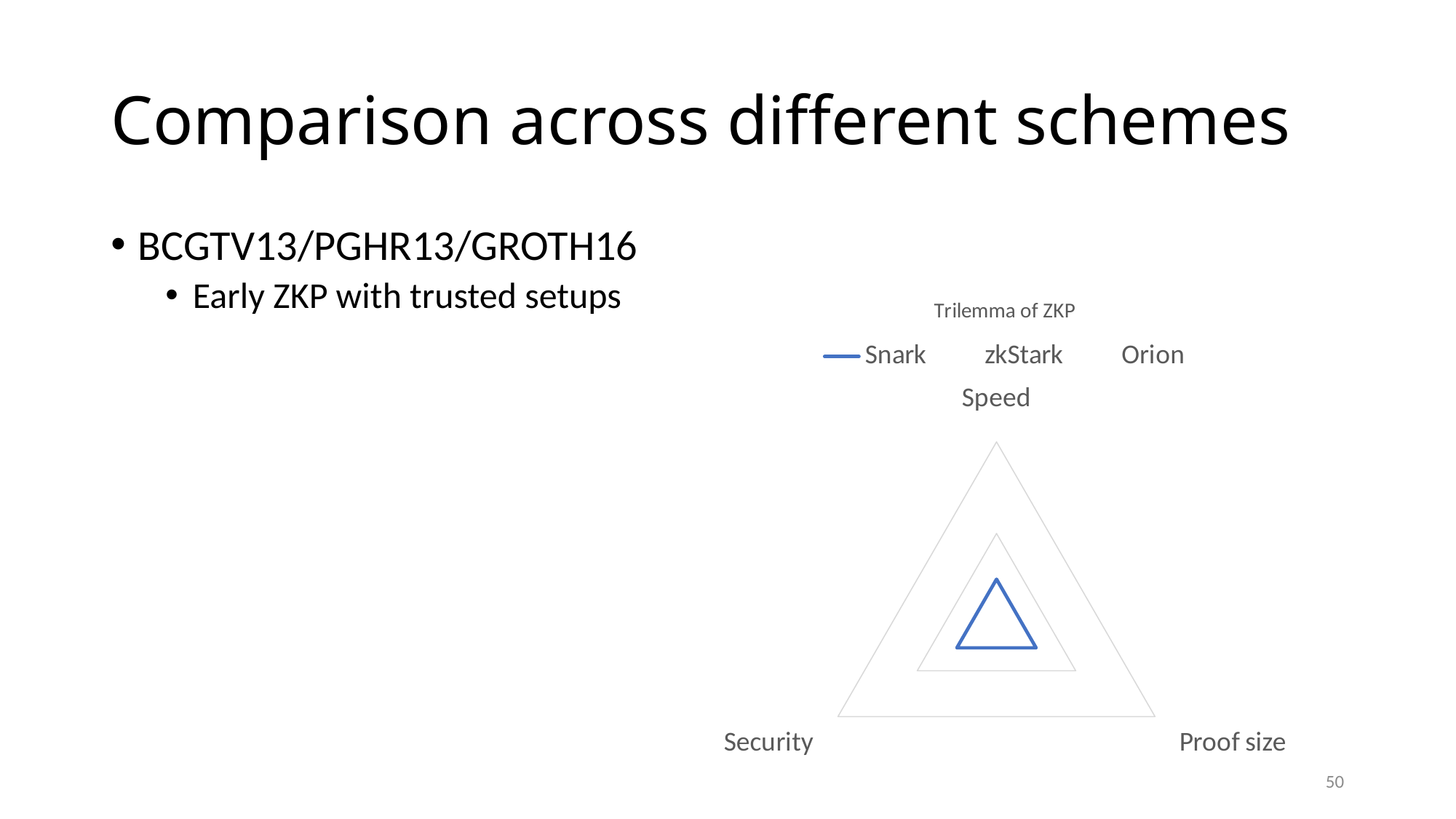
How many axes (categories) does the radar chart have? 3 Which category label appears at the bottom right of the radar chart? Proof size Which category label appears at the top of the radar chart? Speed Which series is drawn with a blue line in the chart? Snark Which category label appears at the bottom left of the radar chart? Security What is the title of the chart on the slide? Trilemma of ZKP How many series does the chart legend list? 3 What kind of chart is shown on the slide? Radar chart